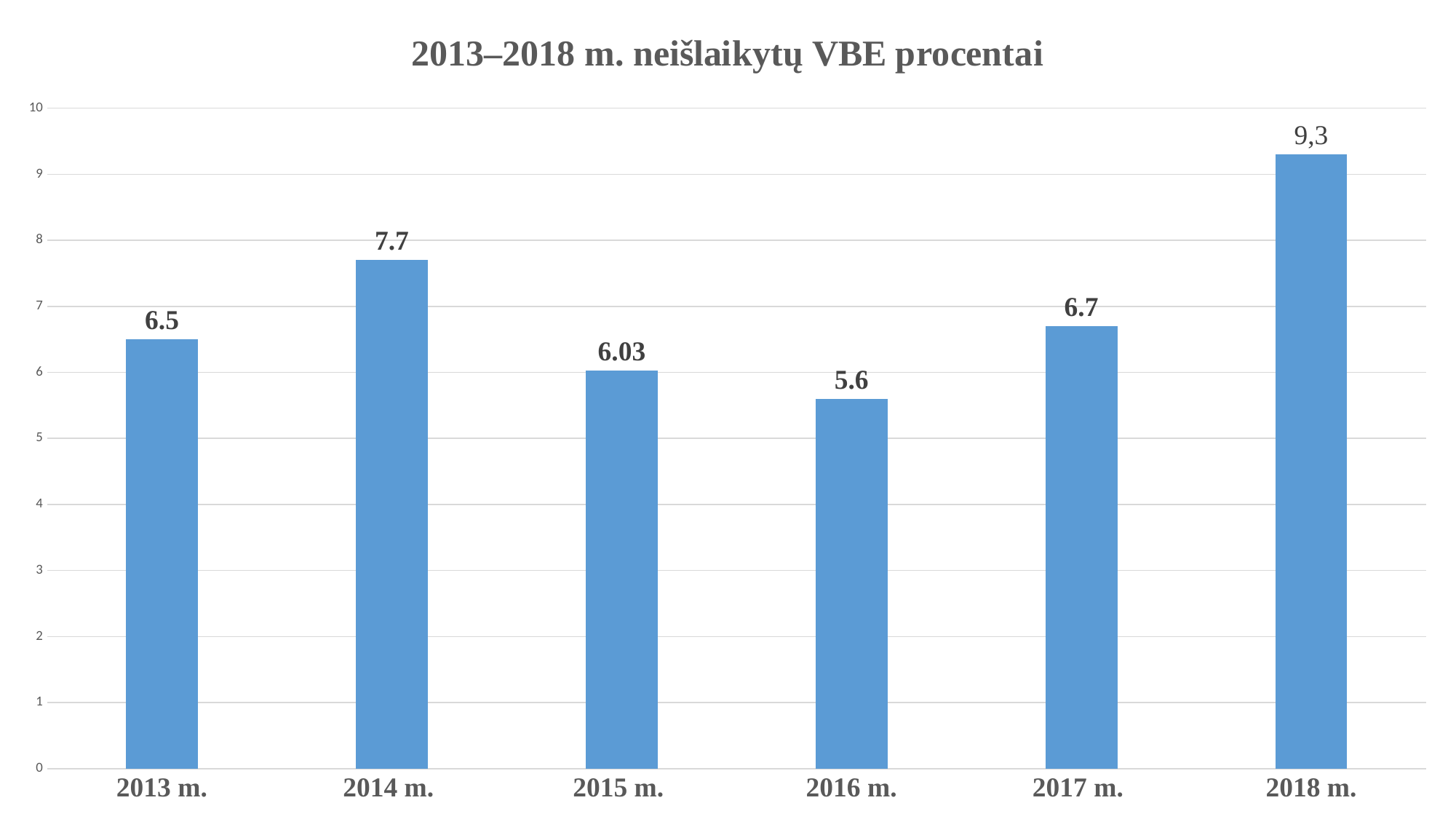
What is the title of the chart? 2013–2018 m. neišlaikytų VBE procentai Which year has the lowest value? 2016 m. What is the value for 2018 m.? 9,3 What is the value for 2015 m.? 6.03 Which year has the highest value? 2018 m. How many years are shown on the chart? 6 What is the value for 2013 m.? 6.5 Does the value rise or fall from 2016 m. to 2018 m.? rise Which is larger, the value for 2017 m. or the value for 2015 m.? 2017 m. What kind of chart is this? bar chart Is the value for 2014 m. greater or less than 7? greater What is the difference between the values for 2014 m. and 2013 m.? 1.2